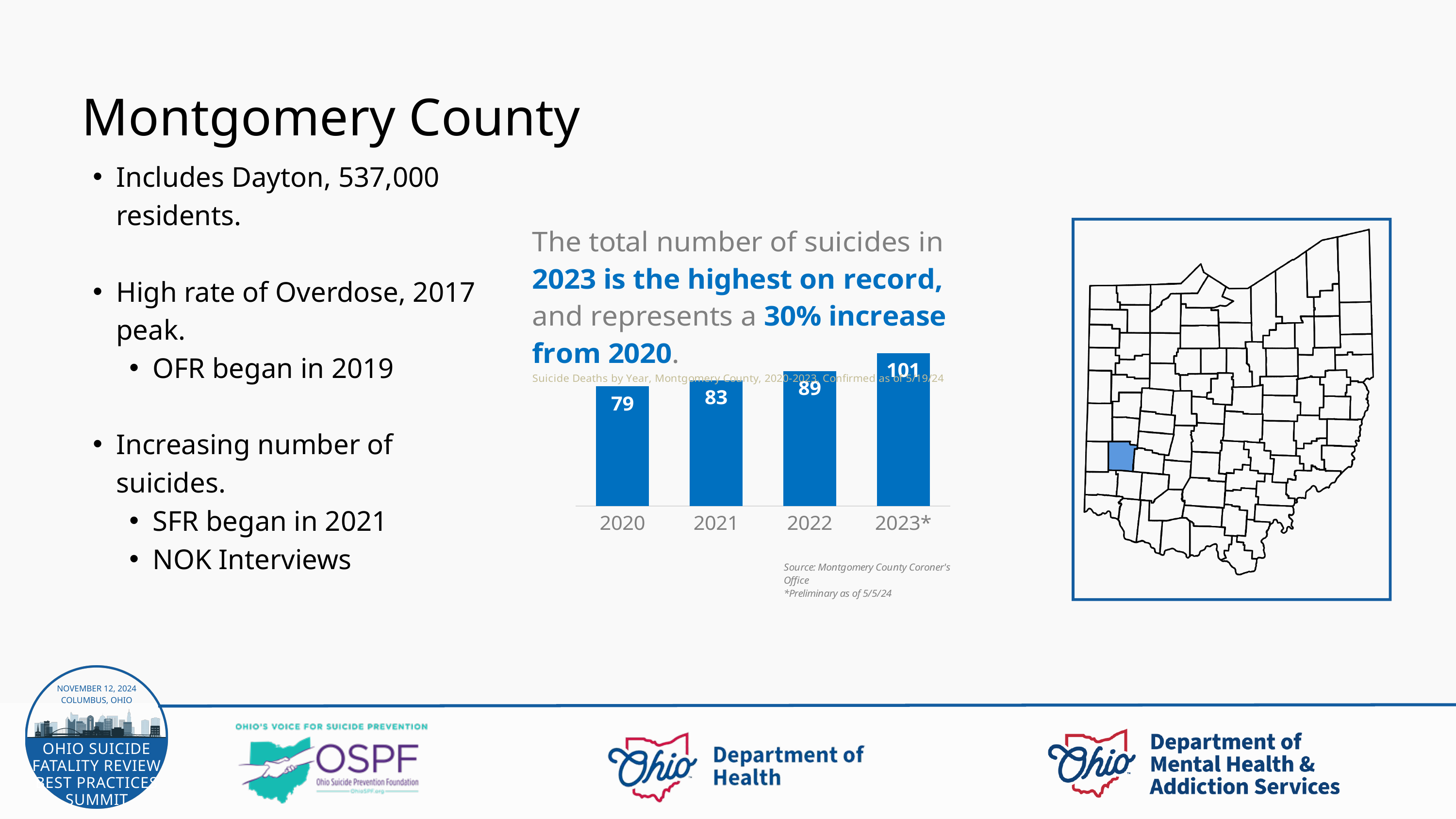
Which year has the lowest number of suicide deaths? 2020 Which year has the highest number of suicide deaths? 2023* What is the difference between the suicide deaths in 2023* and 2020? 22 What kind of chart is used to show suicide deaths by year? Bar chart Do the suicide death counts rise or fall from 2020 to 2023*? Rise What is the number of suicide deaths shown for 2022? 89 What is the difference between the suicide deaths in 2022 and 2021? 6 What is the number of suicide deaths shown for 2023*? 101 How many years are shown on the x axis of the chart? 4 Which year has more suicide deaths, 2021 or 2022? 2022 What is the number of suicide deaths shown for 2020? 79 What is the number of suicide deaths shown for 2021? 83